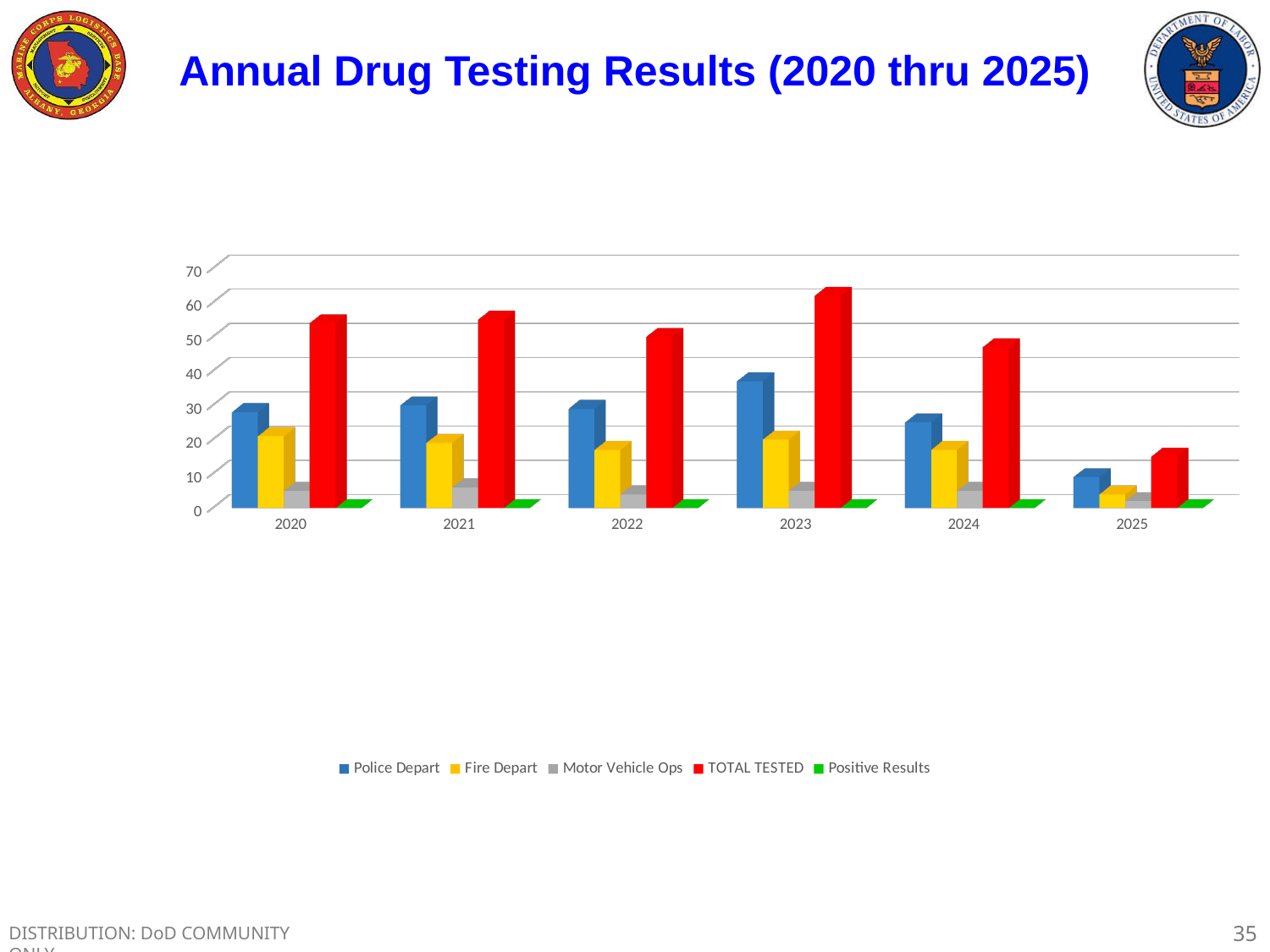
What kind of chart is shown on the slide? bar chart Is the Fire Depart value for 2025 greater or less than 10? less In 2020, which is larger: the Police Depart value or the Fire Depart value? Police Depart How many years are shown on the x axis of the chart? 6 In which year is the TOTAL TESTED bar the highest? 2023 Is the TOTAL TESTED value for 2023 greater or less than 60? greater How many series does the chart legend list? 5 In which year is the TOTAL TESTED bar the lowest? 2025 Does the TOTAL TESTED value rise or fall from 2024 to 2025? fall Is the TOTAL TESTED value for 2025 greater or less than 20? less In which year is the Police Depart bar the highest? 2023